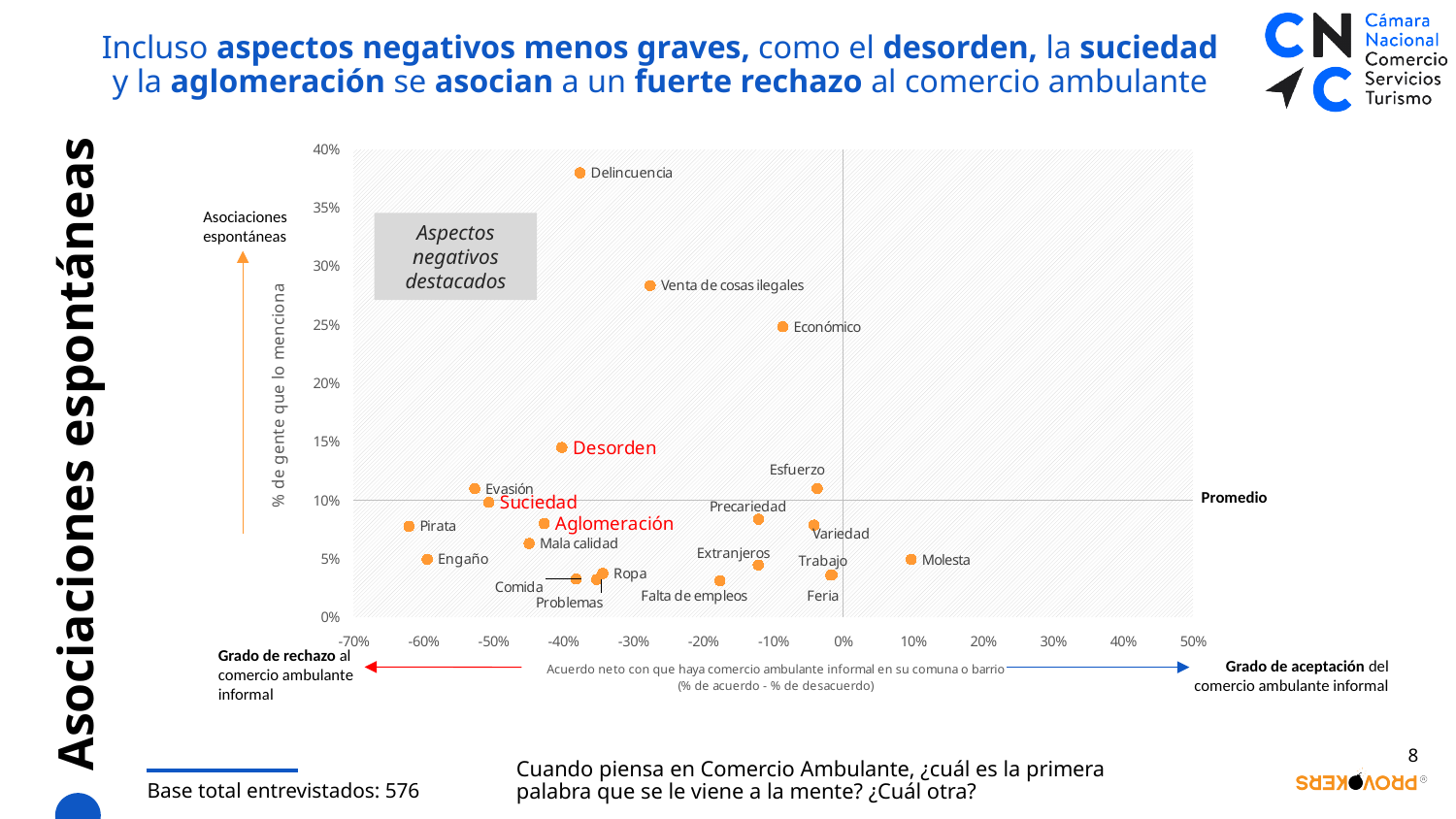
What is the label of the horizontal axis of the chart? Acuerdo neto con que haya comercio ambulante informal en su comuna o barrio (% de acuerdo - % de desacuerdo) Is the percentage of people mentioning Desorden greater or less than 10%? greater Which association has the highest net agreement (furthest right on the horizontal axis)? Molesta At what value on the vertical axis is the 'Promedio' line drawn? 10% Which association has the highest percentage of people mentioning it? Delincuencia Is the percentage of people mentioning Económico greater or less than 20%? greater Is the net agreement value for Pirata greater or less than -50%? less Which is mentioned by a larger percentage of people, Desorden or Suciedad? Desorden What kind of chart is shown on the slide? scatter chart Which is mentioned by a larger percentage of people, Económico or Esfuerzo? Económico